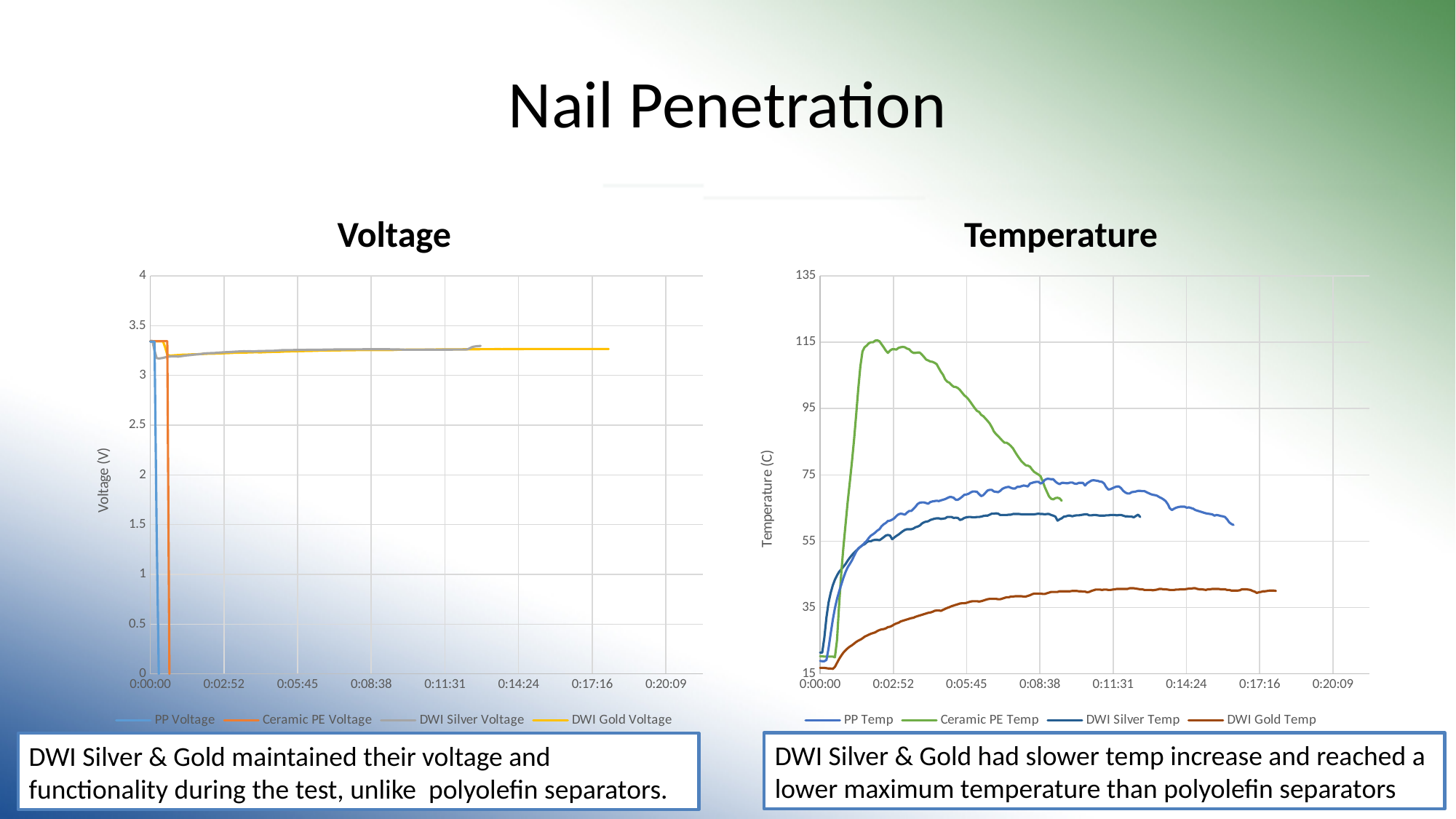
In the Temperature chart, is the peak value of Ceramic PE Temp greater or less than 95? greater What kind of chart is the Voltage chart? line chart What is the y-axis label of the Temperature chart? Temperature (C) How many series does the legend of the Voltage chart list? 4 In the Voltage chart, which two series drop to 0 shortly after the start? PP Voltage and Ceramic PE Voltage In the Temperature chart, which series stays the lowest throughout the test? DWI Gold Temp In the Voltage chart, is the value of DWI Gold Voltage at 0:17:16 greater or less than 3? greater In the Temperature chart, does the DWI Gold Temp series generally rise or fall over the test? rise How many series does the legend of the Temperature chart list? 4 In the Temperature chart, is the highest value of DWI Gold Temp greater or less than 55? less In the Temperature chart, which series reaches the highest temperature? Ceramic PE Temp In the Temperature chart, which peaks higher, PP Temp or Ceramic PE Temp? Ceramic PE Temp